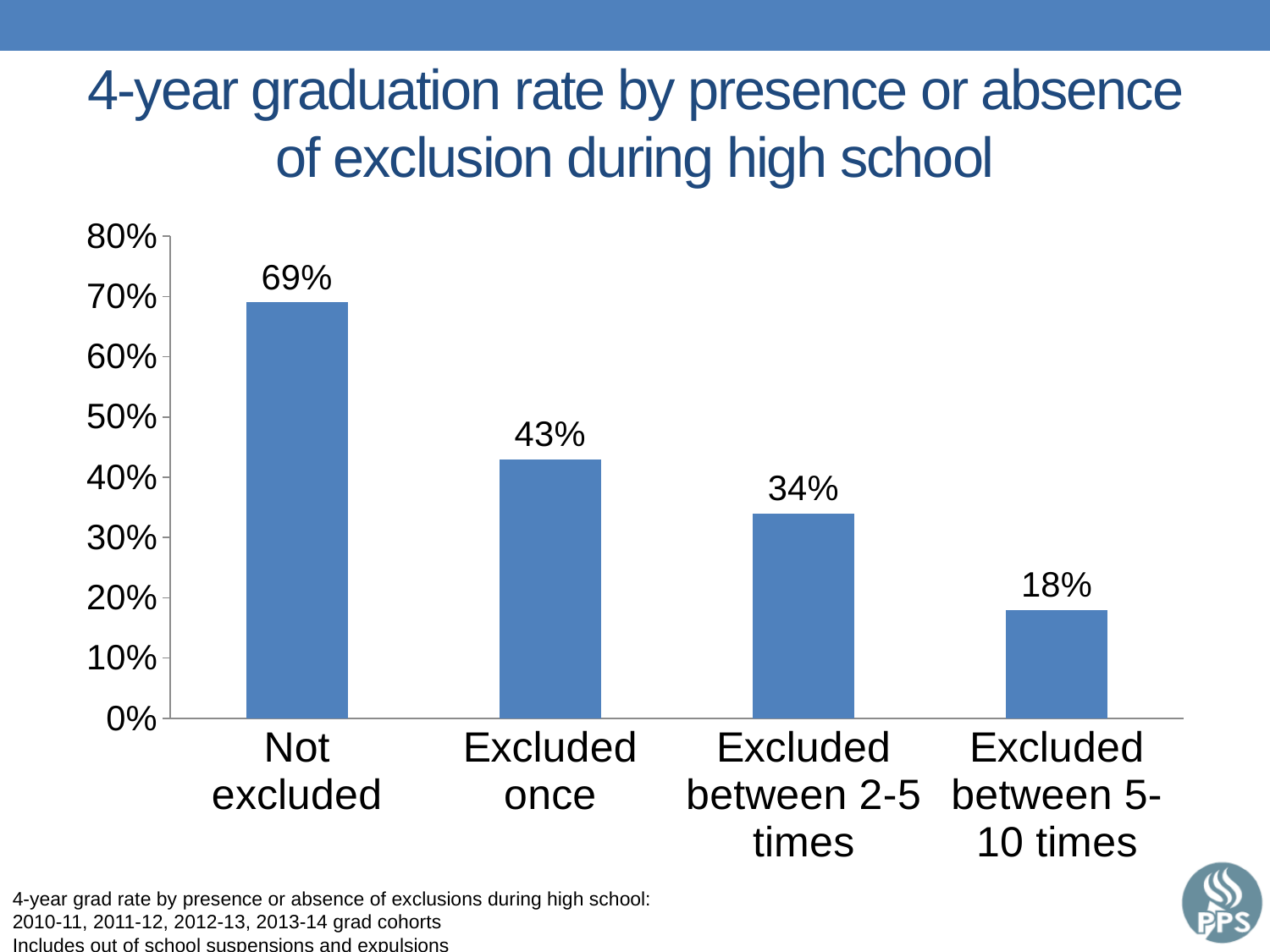
What is the 4-year graduation rate for students excluded once? 43% How many categories are shown on the chart? 4 What is the 4-year graduation rate for students excluded between 2-5 times? 34% What kind of chart is shown on the slide? Bar chart What is the difference in graduation rate between students not excluded and students excluded once? 26% What is the 4-year graduation rate for students who were not excluded? 69% What is the difference in graduation rate between students excluded between 2-5 times and students excluded between 5-10 times? 16% What is the 4-year graduation rate for students excluded between 5-10 times? 18% Which category has the lowest 4-year graduation rate? Excluded between 5-10 times Do the graduation rates rise or fall moving from left to right across the categories? Fall Which category has the highest 4-year graduation rate? Not excluded Which has a higher graduation rate: students excluded once or students excluded between 2-5 times? Excluded once